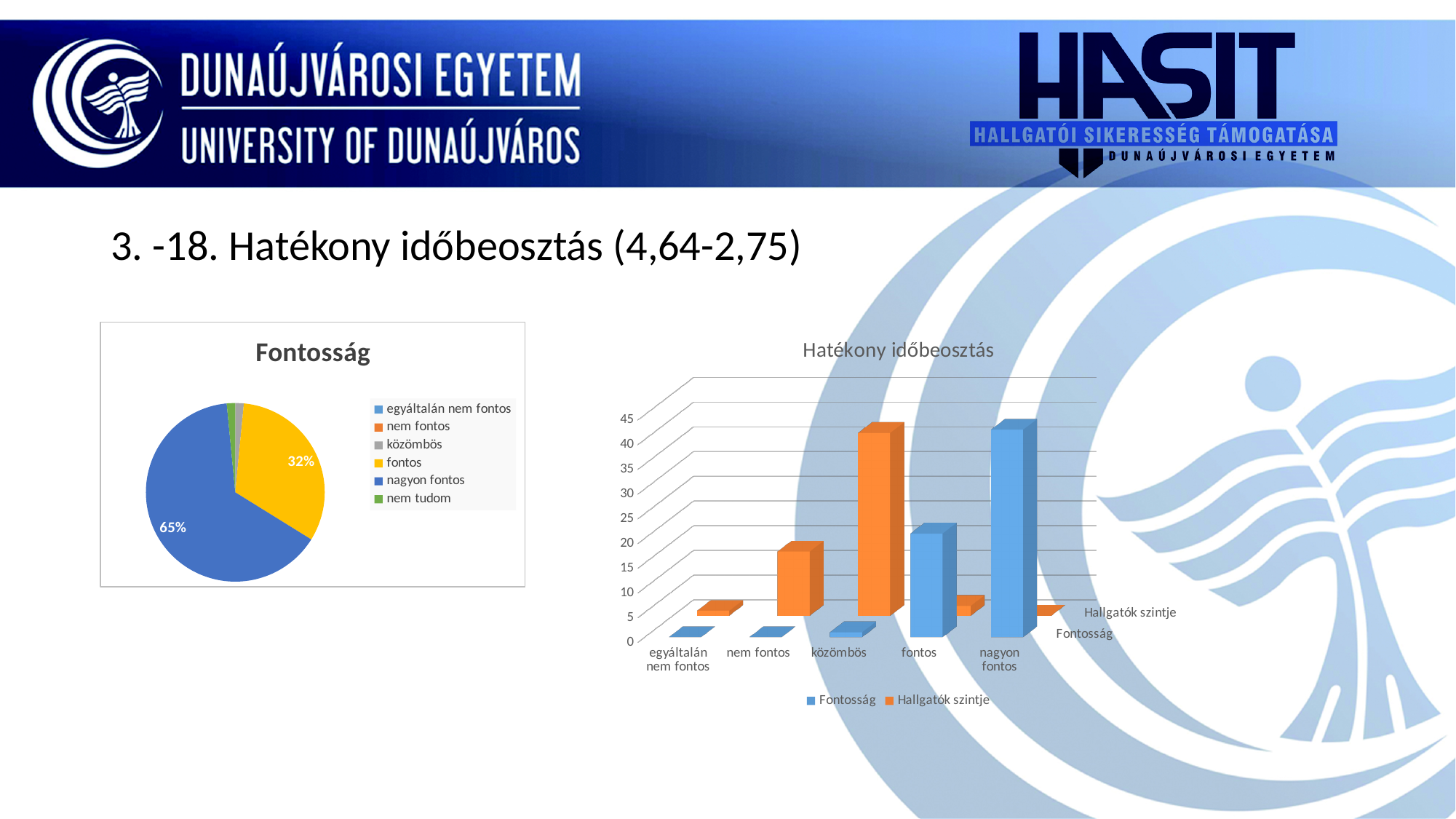
What kind of chart is the chart titled Hatékony időbeosztás? bar chart In the pie chart titled Fontosság, how many percentage points larger is the nagyon fontos slice than the fontos slice? 33 In the chart titled Hatékony időbeosztás, how many series does the legend list? 2 In the pie chart titled Fontosság, how many categories does the legend list? 6 In the chart titled Hatékony időbeosztás, how many categories are shown on the x axis? 5 In the chart titled Hatékony időbeosztás, is the Fontosság value for nagyon fontos greater or less than 30? greater In the pie chart titled Fontosság, what percentage is shown for the fontos slice? 32% In the pie chart titled Fontosság, what percentage is shown for the nagyon fontos slice? 65% In the pie chart titled Fontosság, which category has the largest slice? nagyon fontos In the chart titled Hatékony időbeosztás, for the category fontos, which series has the larger value, Fontosság or Hallgatók szintje? Fontosság In the chart titled Hatékony időbeosztás, which category has the highest Hallgatók szintje value? közömbös In the chart titled Hatékony időbeosztás, is the Hallgatók szintje value for nem fontos greater or less than 10? greater